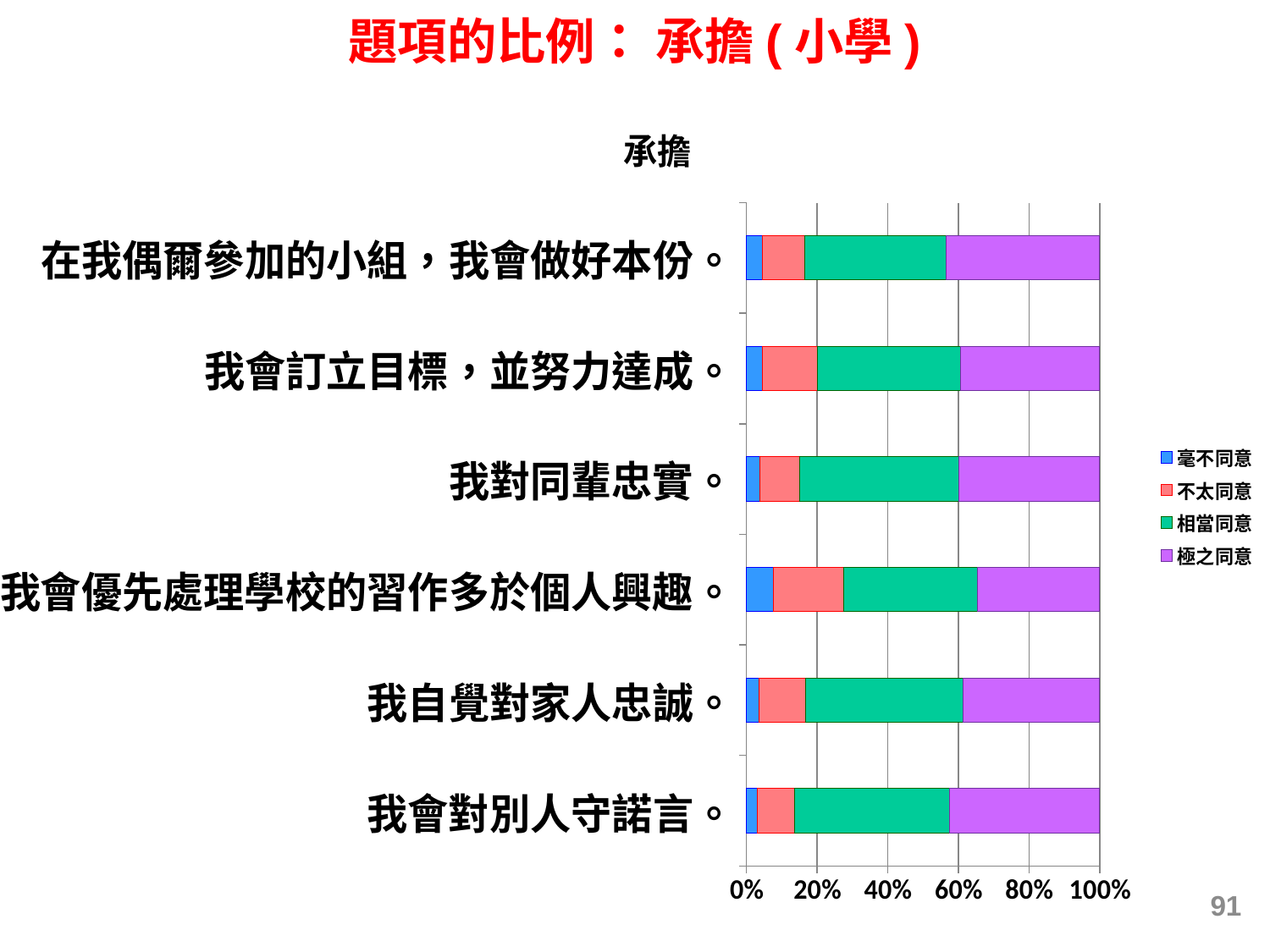
What kind of chart is shown on the slide? Stacked bar chart Which has the larger 毫不同意 segment: 我會優先處理學校的習作多於個人興趣 or 我會對別人守諾言? 我會優先處理學校的習作多於個人興趣。 Is the combined share of 毫不同意 and 不太同意 for 在我偶爾參加的小組，我會做好本份 greater or less than 20%? less Which legend entry is shown in purple? 極之同意 How many series does the legend list? 4 What is the title shown above the chart? 承擔 Is the combined share of 毫不同意 and 不太同意 for 我對同輩忠實 greater or less than 20%? less Which item has the largest 毫不同意 segment? 我會優先處理學校的習作多於個人興趣。 What does each stacked bar total at its right end on the axis? 100% Which item has the largest 不太同意 segment? 我會優先處理學校的習作多於個人興趣。 How many items (categories) are plotted in the chart? 6 Is the combined share of 毫不同意 and 不太同意 for 我會優先處理學校的習作多於個人興趣 greater or less than 20%? greater